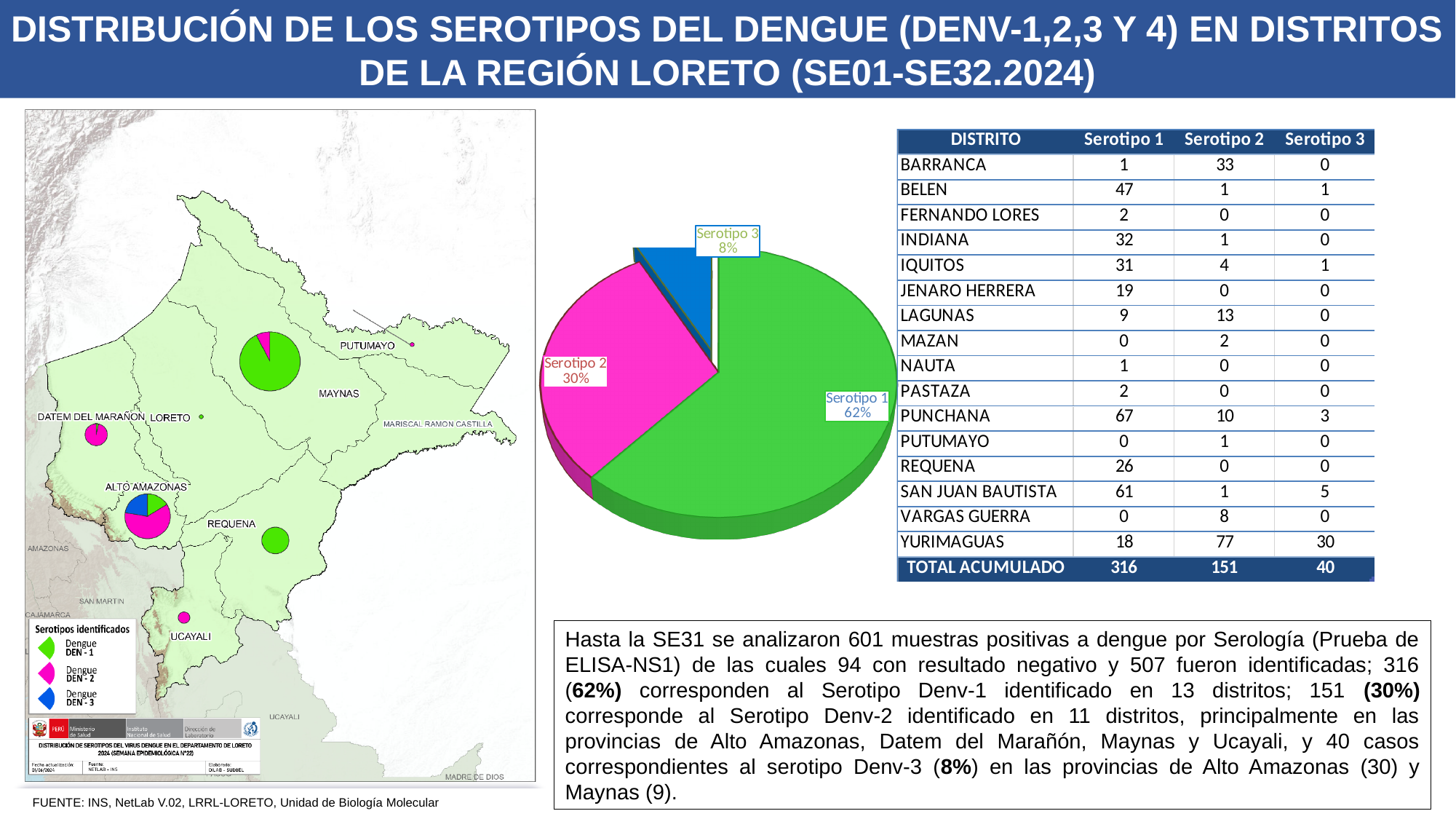
What kind of chart is shown in the middle of the slide? Pie chart In the pie chart, what share does Serotipo 3 have? 8% In the pie chart, how many percentage points larger is Serotipo 1 than Serotipo 2? 32 How many slices does the pie chart have? 3 In the pie chart, what share does Serotipo 1 have? 62% In the pie chart, what share does Serotipo 2 have? 30% In the pie chart, how many percentage points larger is Serotipo 2 than Serotipo 3? 22 In the pie chart, how many percentage points larger is Serotipo 1 than Serotipo 3? 54 In the pie chart, what colour is the slice for Serotipo 3? Blue In the pie chart, which serotype has the smallest slice? Serotipo 3 In the pie chart, which is larger, the slice for Serotipo 2 or the slice for Serotipo 3? Serotipo 2 In the pie chart, which serotype has the largest slice? Serotipo 1